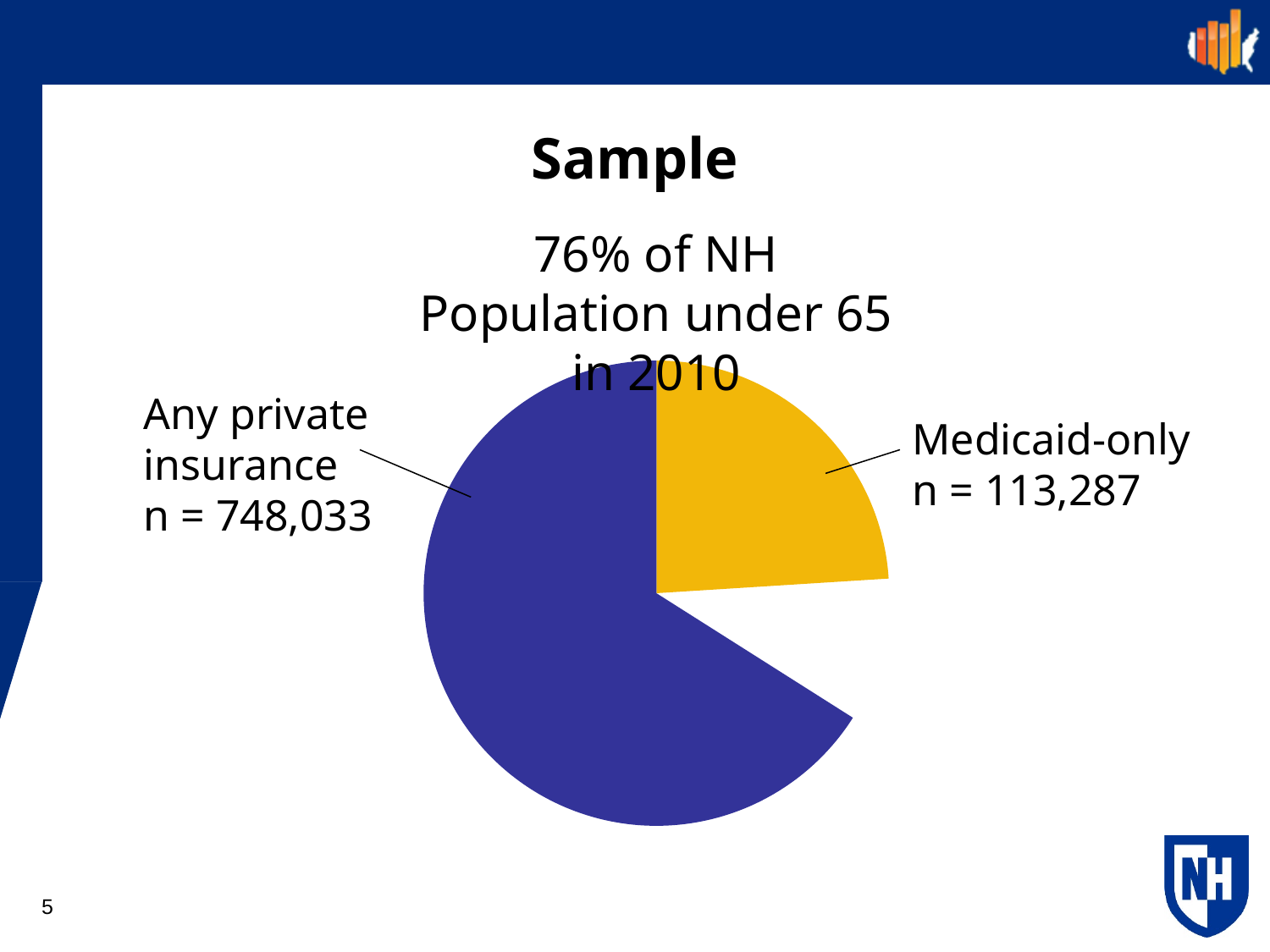
What is the n value for Medicaid-only in the pie chart? 113,287 Which category has the largest slice of the pie chart? Any private insurance What colour is the Medicaid-only slice in the pie chart? Yellow What is the n value for Any private insurance in the pie chart? 748,033 What type of chart is shown on the slide? Pie chart How many categories are shown in the pie chart? 2 What is the difference between the n for Any private insurance and the n for Medicaid-only? 634,746 Which category has the smallest slice of the pie chart? Medicaid-only Which is larger, the n for Any private insurance or the n for Medicaid-only? Any private insurance What is the title of the pie chart? 76% of NH Population under 65 in 2010 What is the combined n of the two slices in the pie chart? 861,320